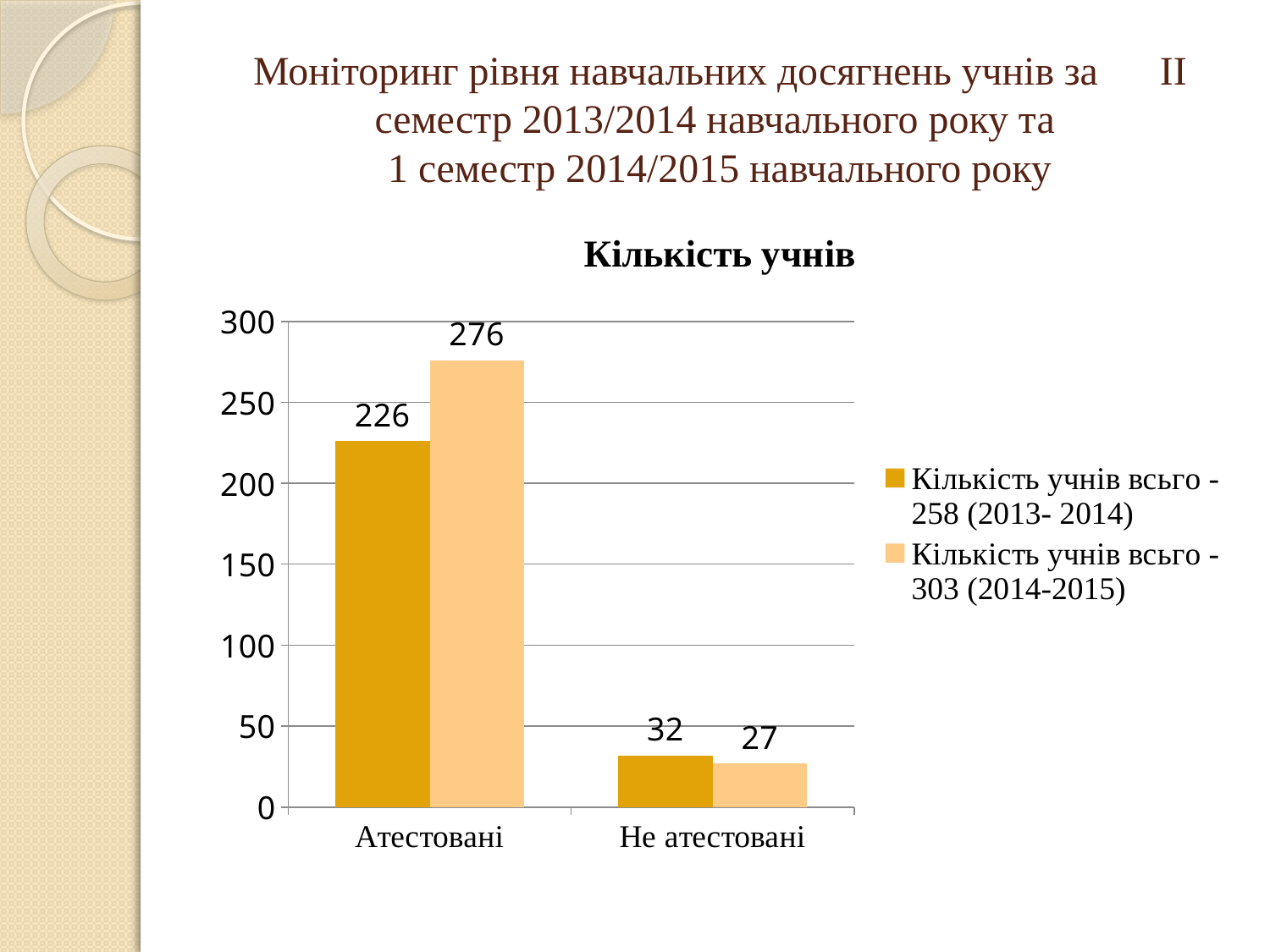
How many categories are shown on the x axis? 2 What kind of chart is shown on the slide? Bar chart For Не атестовані, which series has the larger value: 2013-2014 or 2014-2015? 2013-2014 Which category has the lowest value in the series 'Кількість учнів всього - 258 (2013- 2014)'? Не атестовані What is the difference between the two series' values for Не атестовані? 5 What is the value for Не атестовані in the series 'Кількість учнів всього - 303 (2014-2015)'? 27 What is the value for Атестовані in the series 'Кількість учнів всього - 303 (2014-2015)'? 276 What is the value for Не атестовані in the series 'Кількість учнів всього - 258 (2013- 2014)'? 32 What is the difference between the two series' values for Атестовані? 50 What is the value for Атестовані in the series 'Кількість учнів всього - 258 (2013- 2014)'? 226 How many series does the legend list? 2 Which category has the highest value in the series 'Кількість учнів всього - 303 (2014-2015)'? Атестовані